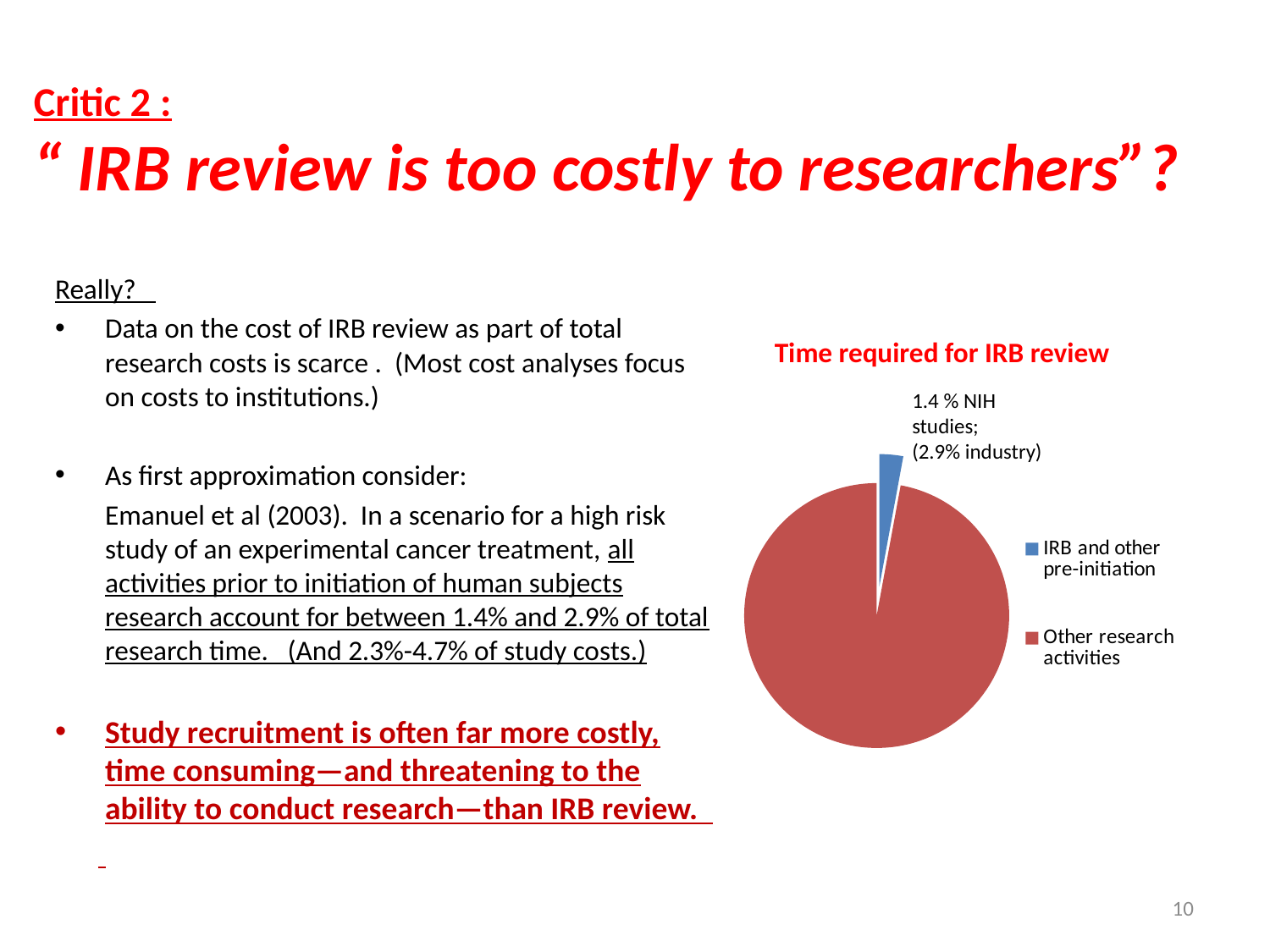
According to the label on the pie chart, what share of time do IRB and other pre-initiation activities take for NIH studies? 1.4 % Which is larger in the pie chart: 'IRB and other pre-initiation' or 'Other research activities'? Other research activities How many entries does the chart legend list? 2 How many slices does the pie chart have? 2 What label is printed next to the small blue slice of the pie chart? 1.4 % NIH studies; (2.9% industry) According to the label on the pie chart, what share of time do IRB and other pre-initiation activities take for industry studies? 2.9% Which slice of the pie chart is the largest? Other research activities What kind of chart is shown on the slide? Pie chart Which slice of the pie chart is the smallest? IRB and other pre-initiation What colour is the 'Other research activities' slice in the pie chart? Red What is the title of the chart? Time required for IRB review